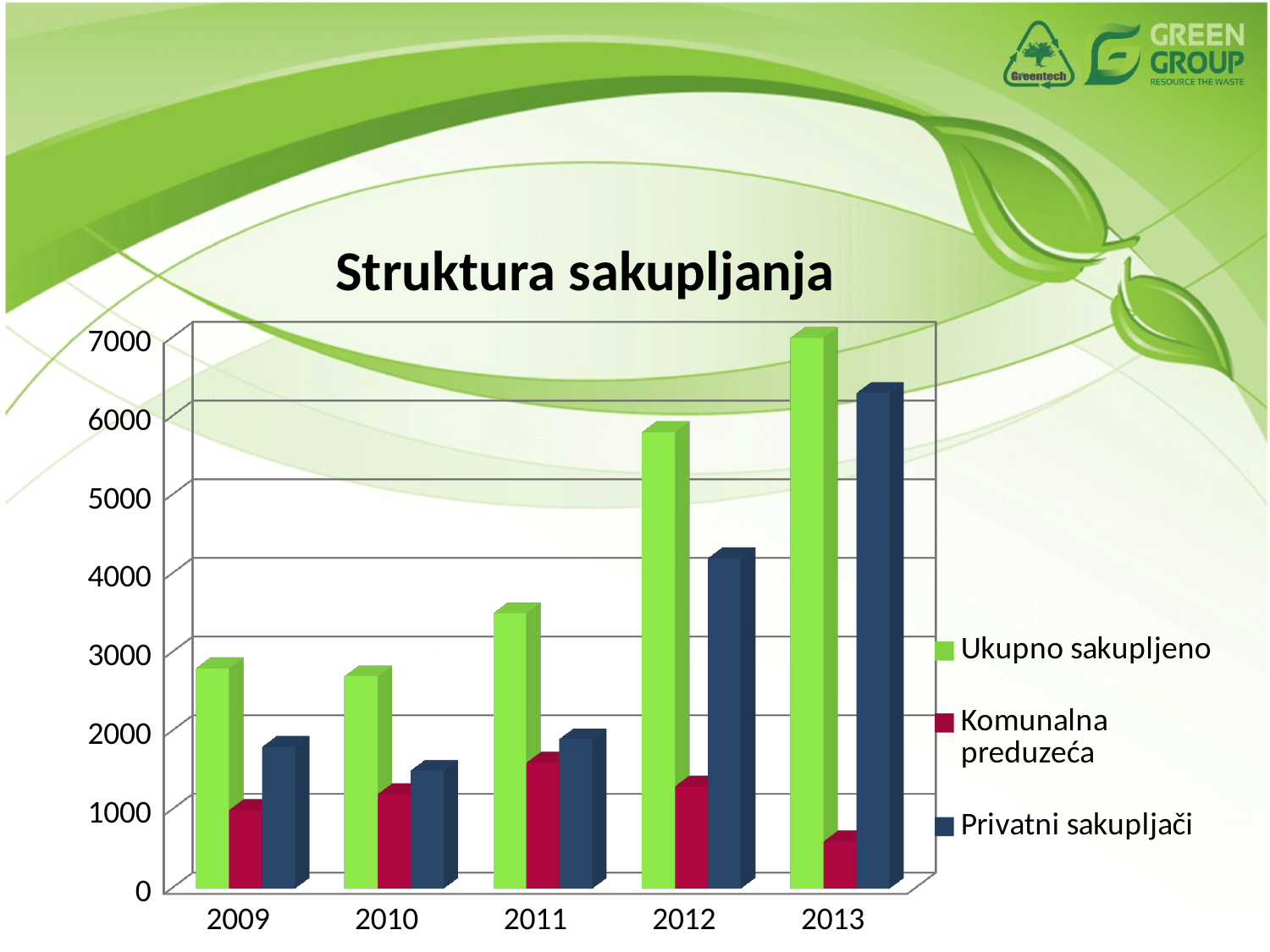
Is the value for Ukupno sakupljeno in 2013 greater or less than 6000? greater Does the value for Privatni sakupljači rise or fall from 2011 to 2013? rise How many years are shown on the x axis? 5 How many series does the legend list? 3 In which year is the value for Ukupno sakupljeno highest? 2013 What kind of chart is shown on the slide? bar chart Is the value for Komunalna preduzeća in 2013 greater or less than 1000? less Is the value for Privatni sakupljači in 2012 greater or less than 3000? greater In which year is the value for Komunalna preduzeća lowest? 2013 In 2012, which is larger: Privatni sakupljači or Komunalna preduzeća? Privatni sakupljači In which year is the value for Privatni sakupljači highest? 2013 What is the title of the chart? Struktura sakupljanja